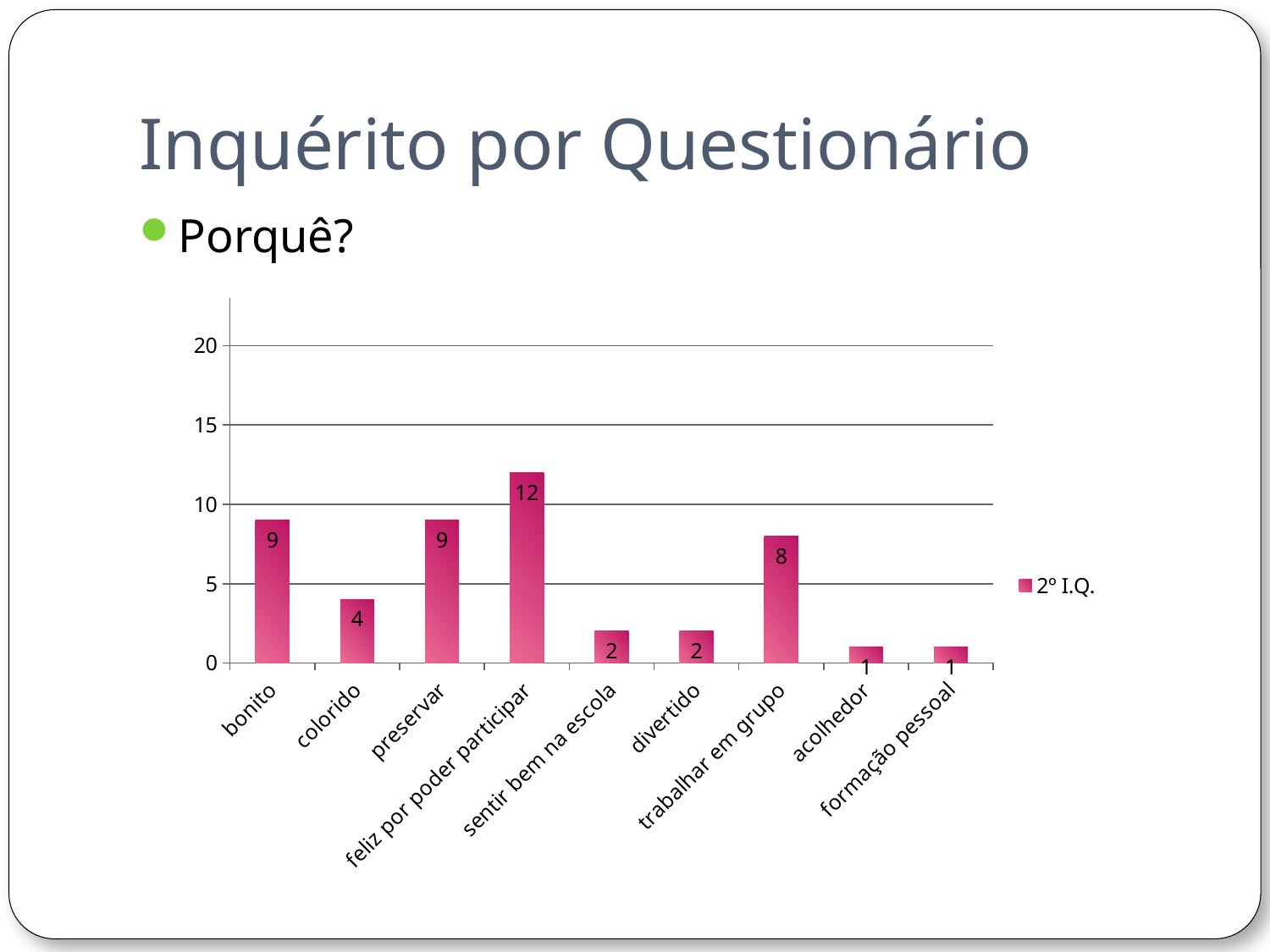
What is the difference between the values for "bonito" and "colorido"? 5 What is the value for "trabalhar em grupo"? 8 Which category has the highest value? feliz por poder participar How many series does the legend list? 1 How many categories are shown on the x axis? 9 Which is larger, the value for "bonito" or the value for "colorido"? bonito What is the value for "colorido"? 4 Is the value for "feliz por poder participar" greater or less than 10? greater What is the difference between the values for "feliz por poder participar" and "trabalhar em grupo"? 4 What kind of chart is shown on the slide? bar chart What is the name of the series in the legend? 2º I.Q. What is the value for "feliz por poder participar"? 12